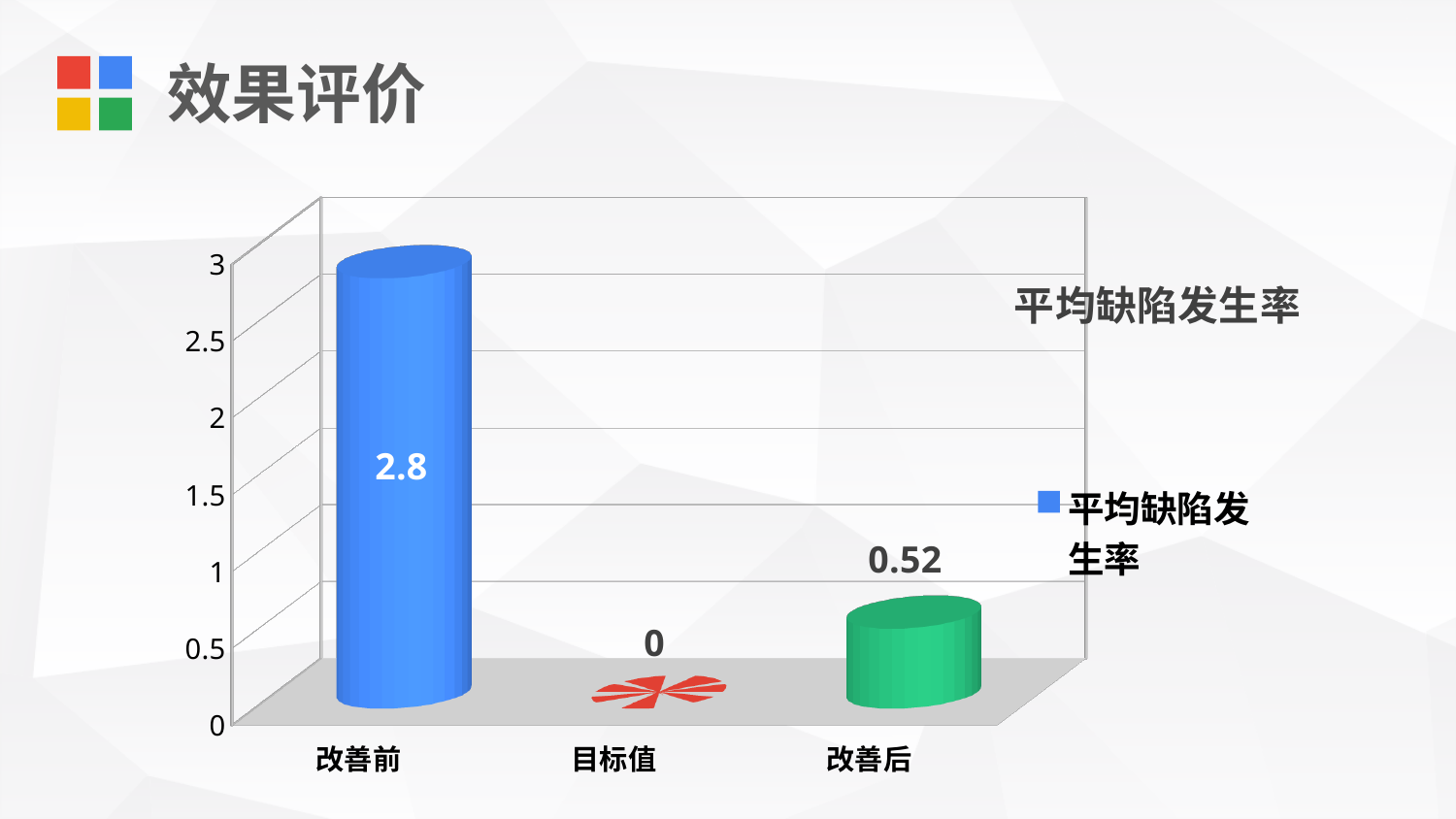
What is the value for 改善前? 2.8 Which category has the lowest value? 目标值 Which category has the highest value? 改善前 What is the value for 目标值? 0 What kind of chart is shown? bar chart What is the value for 改善后? 0.52 How many categories are shown on the x axis? 3 What is the difference between the values for 改善前 and 改善后? 2.28 What is the title of the chart? 平均缺陷发生率 Which is larger, the value for 改善后 or the value for 目标值? 改善后 Is the value for 改善前 greater or less than 2.5? greater How many series does the legend list? 1